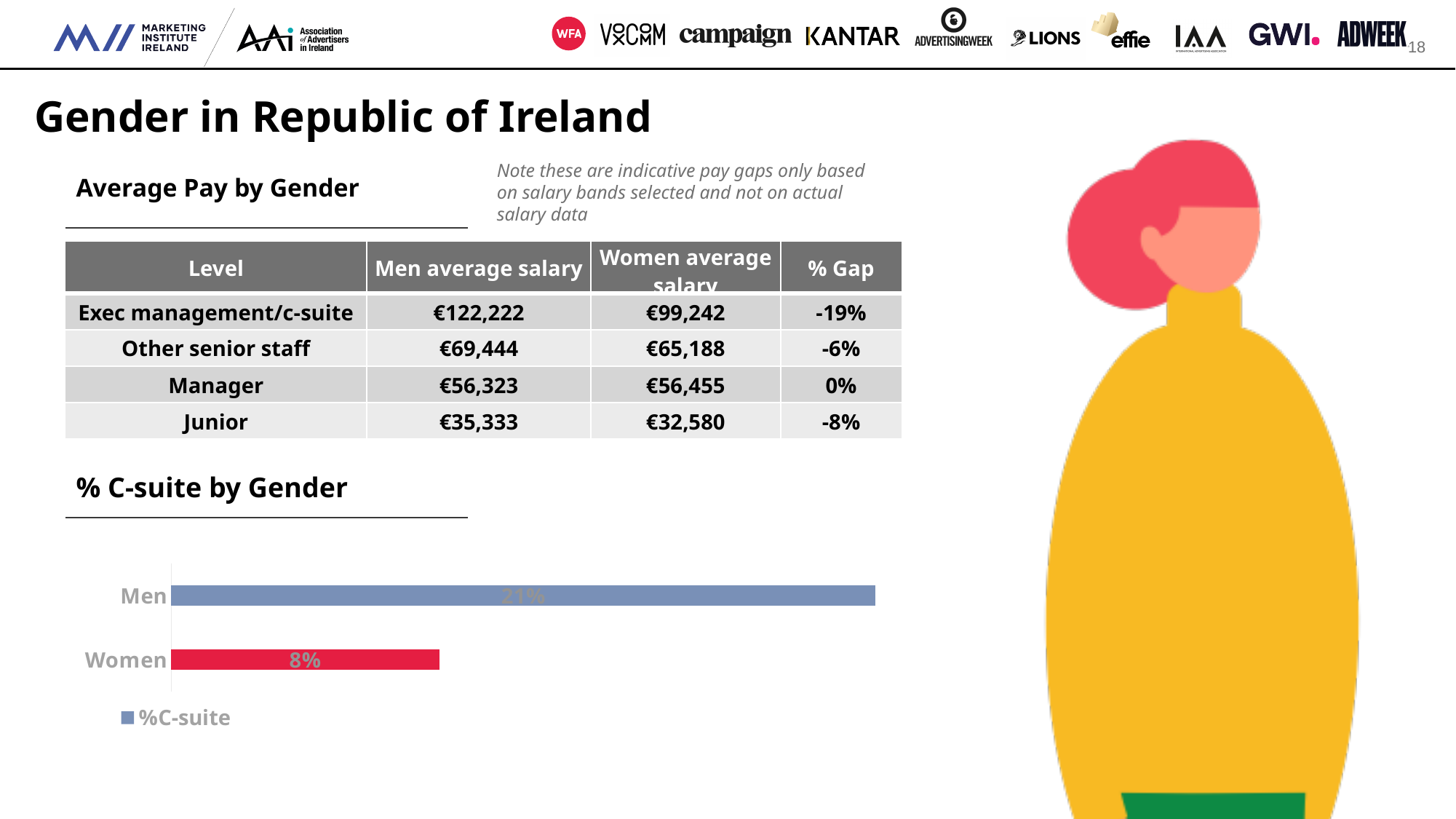
How many series does the legend of the % C-suite by Gender chart list? 1 In the % C-suite by Gender chart, which category has the highest value? Men In the % C-suite by Gender chart, what is the value for Women? 8% In the % C-suite by Gender chart, is the value for Men or Women larger? Men In the % C-suite by Gender chart, which category has the lowest value? Women What kind of chart is the % C-suite by Gender chart? Bar chart What is the legend entry in the % C-suite by Gender chart? %C-suite In the % C-suite by Gender chart, what is the difference between the values for Men and Women? 13% What colour is the Women bar in the % C-suite by Gender chart? Red In the % C-suite by Gender chart, what is the value for Men? 21% How many categories are shown in the % C-suite by Gender chart? 2